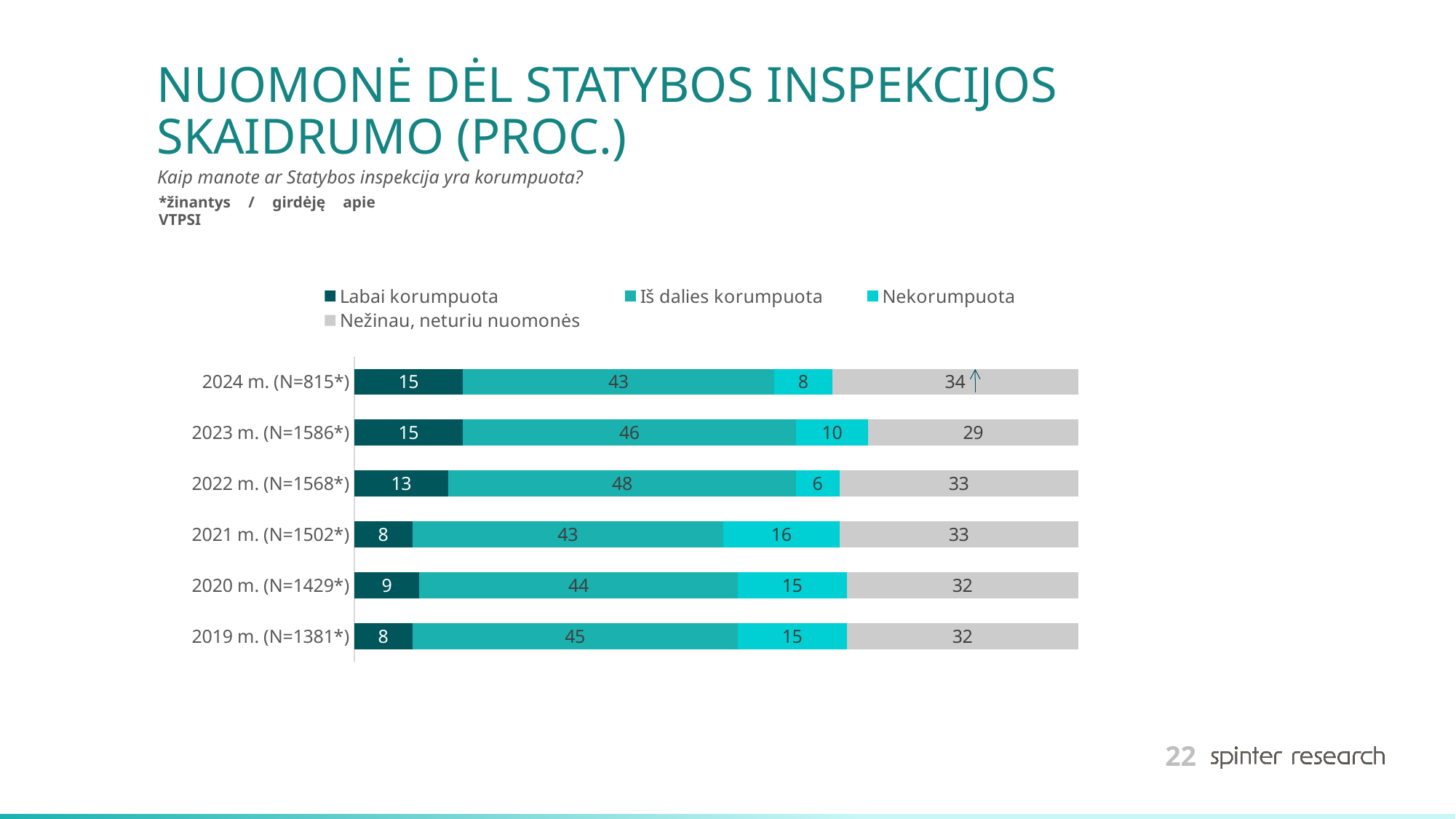
Which is larger, the "Labai korumpuota" value for 2022 m. (N=1568*) or for 2020 m. (N=1429*)? 2022 m. (N=1568*) From 2019 m. to 2024 m., does the "Labai korumpuota" value rise or fall? Rise How many years (categories) are shown in the chart? 6 What is the total of the stacked bar for 2024 m. (N=815*)? 100 What is the value for "Nežinau, neturiu nuomonės" in 2023 m. (N=1586*)? 29 What is the value for "Labai korumpuota" in 2024 m. (N=815*)? 15 Which year has the highest value for "Iš dalies korumpuota"? 2022 m. (N=1568*) How many series does the legend list? 4 What kind of chart is shown on the slide? Stacked bar chart What is the difference between the "Nekorumpuota" values for 2023 m. (N=1586*) and 2024 m. (N=815*)? 2 Which year has the lowest value for "Nekorumpuota"? 2022 m. (N=1568*) What is the value for "Nekorumpuota" in 2021 m. (N=1502*)? 16